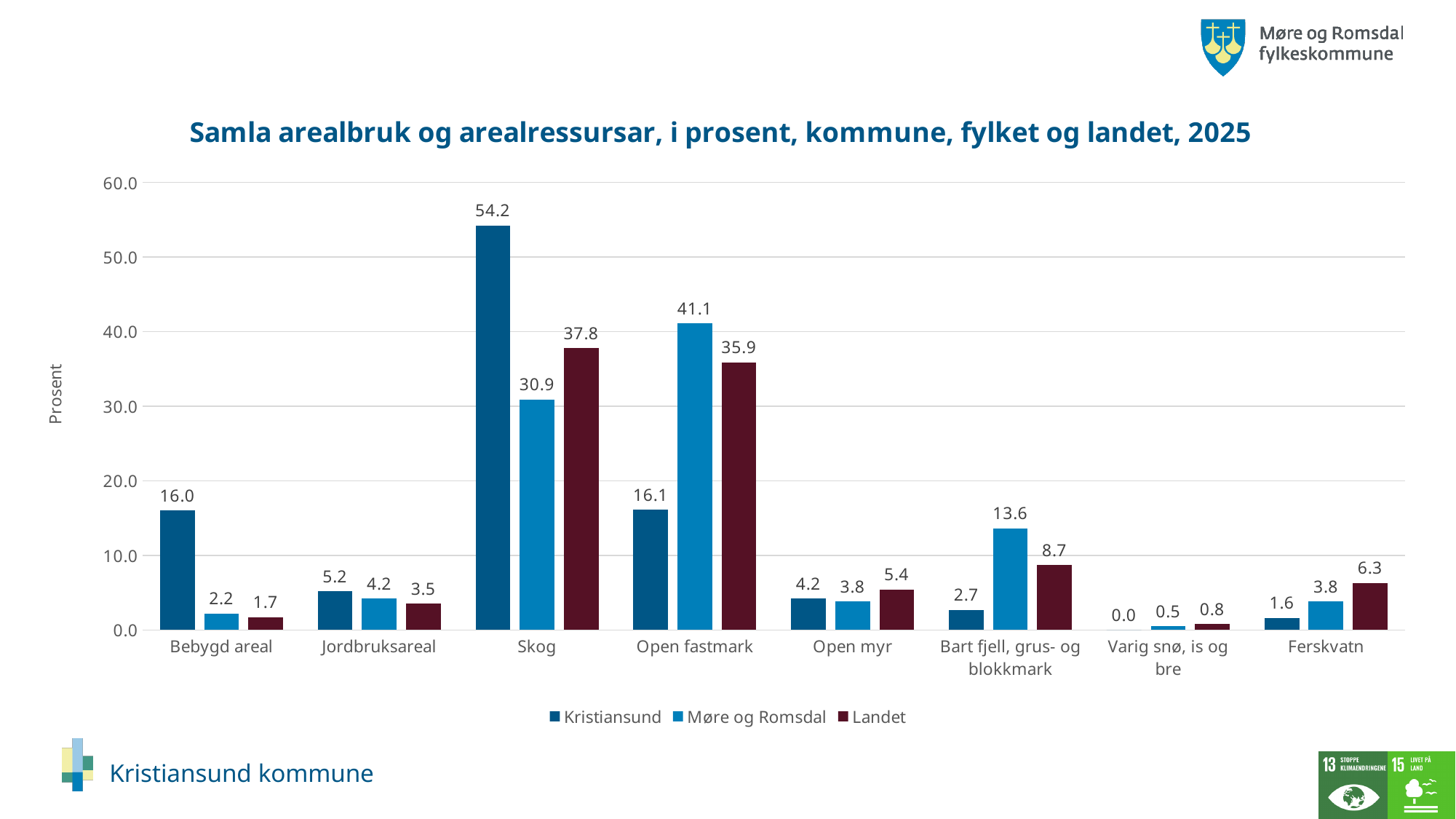
How many categories are shown on the x axis? 8 What is the value for Kristiansund in the Skog category? 54.2 How many series does the legend list? 3 Which category has the highest value for Kristiansund? Skog What is the label on the y axis? Prosent What is the value for Møre og Romsdal in the Bart fjell, grus- og blokkmark category? 13.6 What is the title of the chart? Samla arealbruk og arealressursar, i prosent, kommune, fylket og landet, 2025 Which category has the lowest value for Landet? Varig snø, is og bre What is the difference between the Kristiansund and Landet values for Bebygd areal? 14.3 What is the value for Landet in the Open fastmark category? 35.9 What kind of chart is shown on the slide? Bar chart Which is larger for Open fastmark: the value for Møre og Romsdal or the value for Landet? Møre og Romsdal